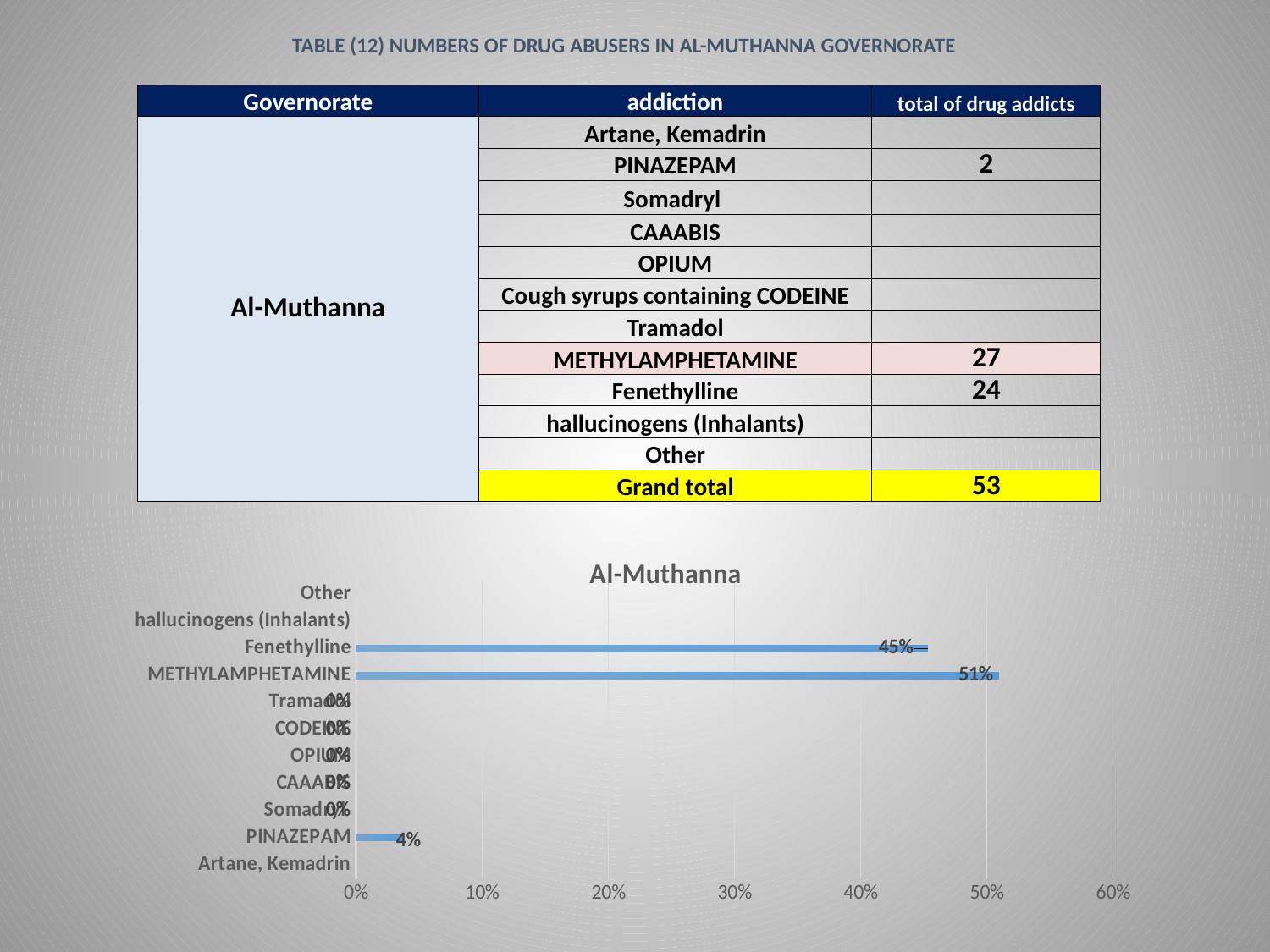
What is the value for Tramadol in the chart? 0% What is the chart's title? Al-Muthanna What is the difference between the values for METHYLAMPHETAMINE and Fenethylline? 6% What is the highest value shown on the horizontal axis of the chart? 60% Which category has the highest value in the chart? METHYLAMPHETAMINE How many categories are listed on the vertical axis of the chart? 11 What kind of chart is shown on the slide? bar chart What is the value for PINAZEPAM in the chart? 4% Is the value for METHYLAMPHETAMINE greater or less than 50%? greater What is the value for Fenethylline in the chart? 45% What is the value for METHYLAMPHETAMINE in the chart? 51% Which is larger, the value for Fenethylline or the value for PINAZEPAM? Fenethylline